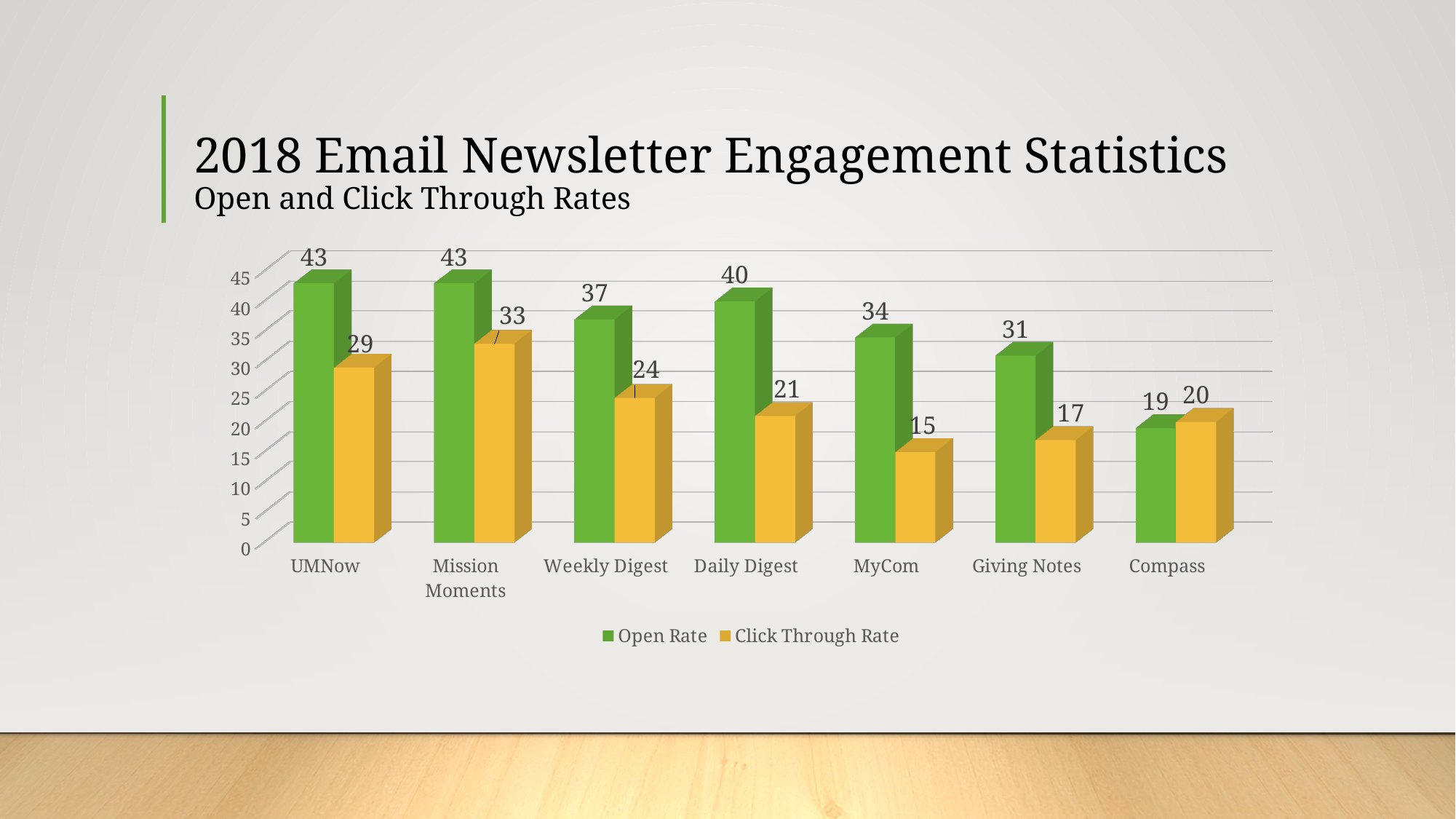
What colour are the Click Through Rate bars? Yellow What is the Open Rate for Daily Digest? 40 Which is larger for Compass, the Open Rate or the Click Through Rate? Click Through Rate Which newsletter has the highest Click Through Rate? Mission Moments What kind of chart is shown on the slide? Bar chart What is the difference between the Open Rate and the Click Through Rate for Weekly Digest? 13 What is the Click Through Rate for Mission Moments? 33 How many newsletters are shown on the x axis? 7 How many series does the legend list? 2 What is the difference between the Open Rate for UMNow and the Open Rate for Giving Notes? 12 Which newsletter has the lowest Open Rate? Compass What is the Click Through Rate for MyCom? 15